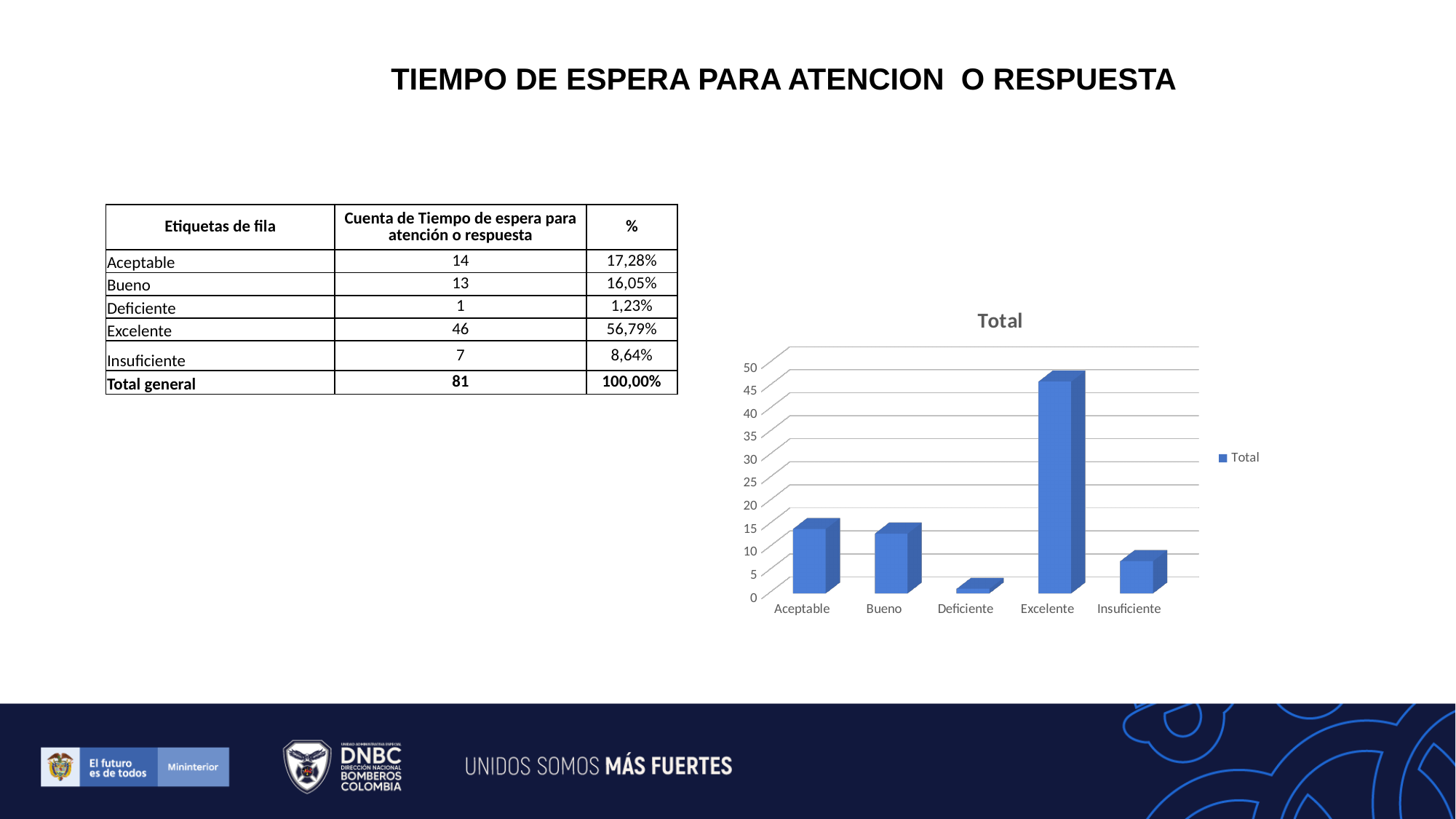
Is the value for Excelente greater or less than 40? greater According to the table on the slide, what is the count for Excelente? 46 How many categories are shown on the x axis of the chart? 5 According to the table on the slide, what is the count for Insuficiente? 7 What is the title of the chart? Total Which category has the highest bar in the chart? Excelente Which category has the lowest bar in the chart? Deficiente Using the counts in the table, what is the difference between Excelente and Bueno? 33 What kind of chart is shown on the slide? bar chart Which is larger, the value for Aceptable or the value for Insuficiente? Aceptable Is the value for Insuficiente greater or less than 10? less How many series does the chart legend list? 1